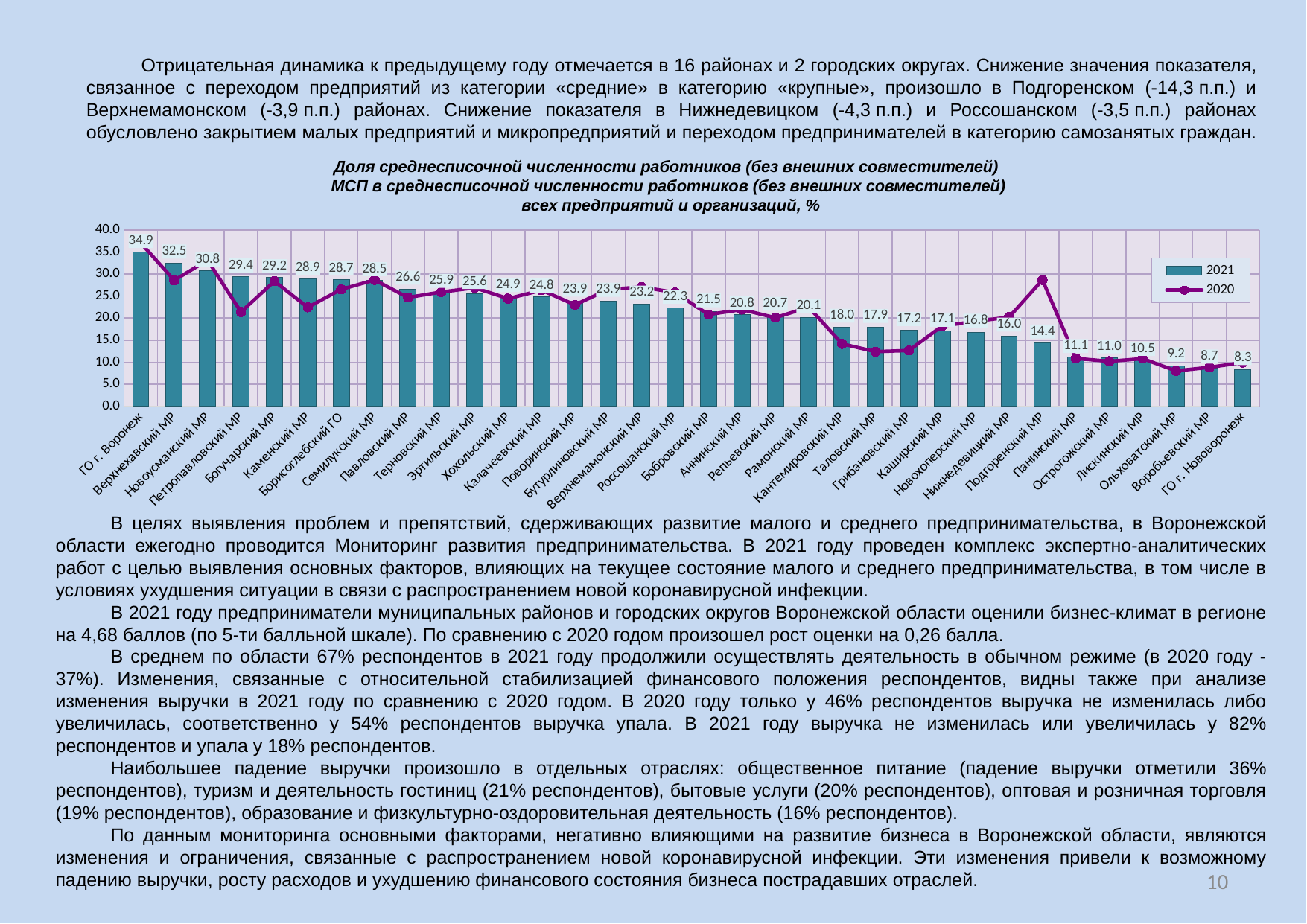
Which has the larger 2021 value, Бобровский МР or Рамонский МР? Бобровский МР How many categories are shown on the x axis? 34 What is the 2021 value for ГО г. Воронеж? 34.9 How many series does the legend list? 2 What is the 2021 value for Россошанский МР? 22.3 What kind of chart is this? Bar chart with a line series Is the 2020 value for Подгоренский МР greater or less than 25.0? greater Which category has the lowest 2021 value? ГО г. Нововоронеж Do the 2021 bar values rise or fall from left to right along the x axis? Fall What is the 2021 value for Подгоренский МР? 14.4 What is the difference between the 2021 values for ГО г. Воронеж and Верхнехавский МР? 2.4 Which category has the highest 2021 value? ГО г. Воронеж